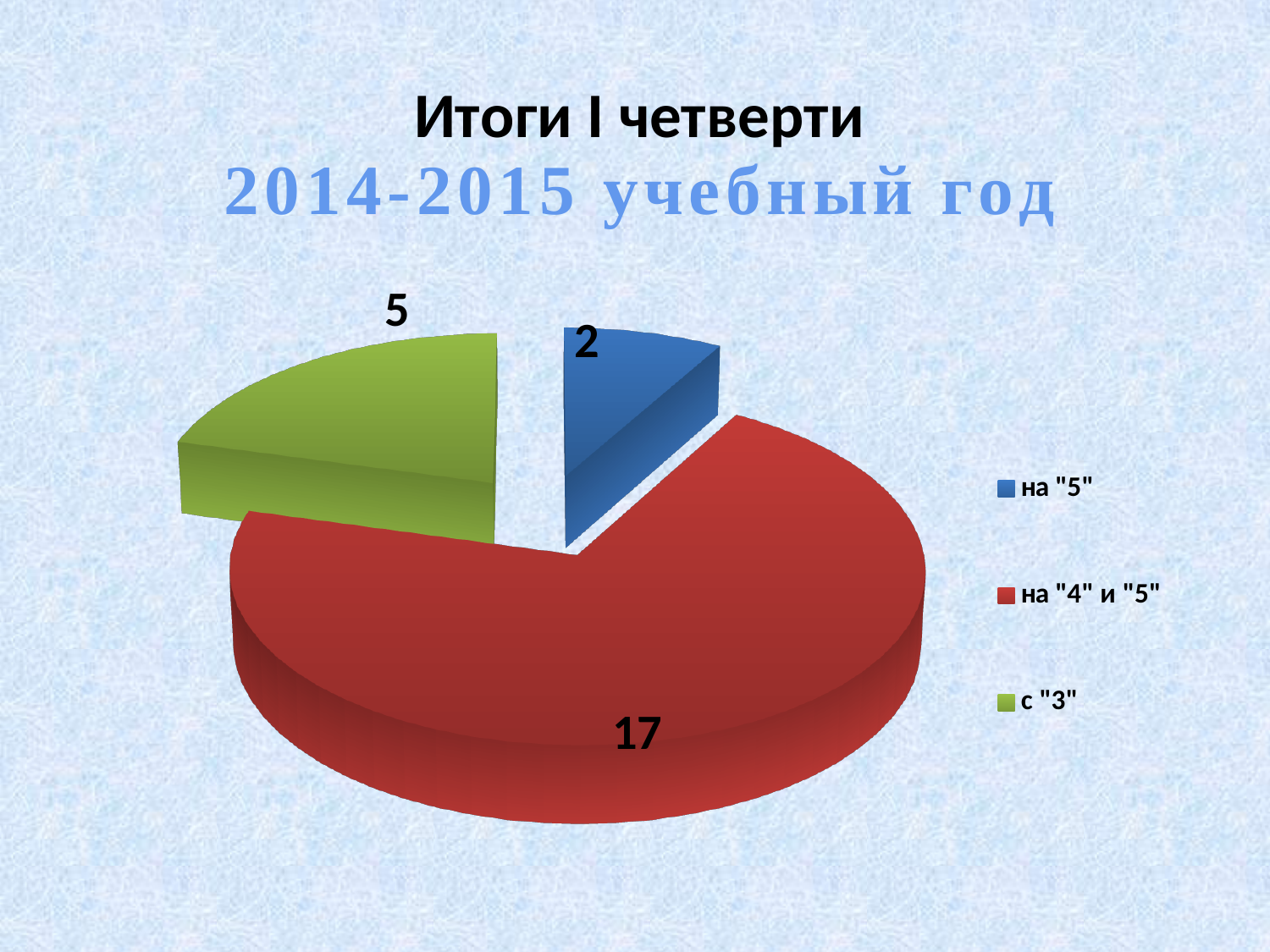
What is the difference between the values for на "4" и "5" and с "3"? 12 What is the value for the slice labelled с "3"? 5 What is the difference between the values for с "3" and на "5"? 3 What is the value for the slice labelled на "5"? 2 What kind of chart is shown on the slide? pie chart How many slices does the pie chart have? 3 What colour is the slice for на "4" и "5"? red Which category has the smallest slice of the pie? на "5" What is the value for the slice labelled на "4" и "5"? 17 What is the total of all the slice values in the pie chart? 24 Which is larger, the value for с "3" or the value for на "5"? с "3" Which category has the largest slice of the pie? на "4" и "5"